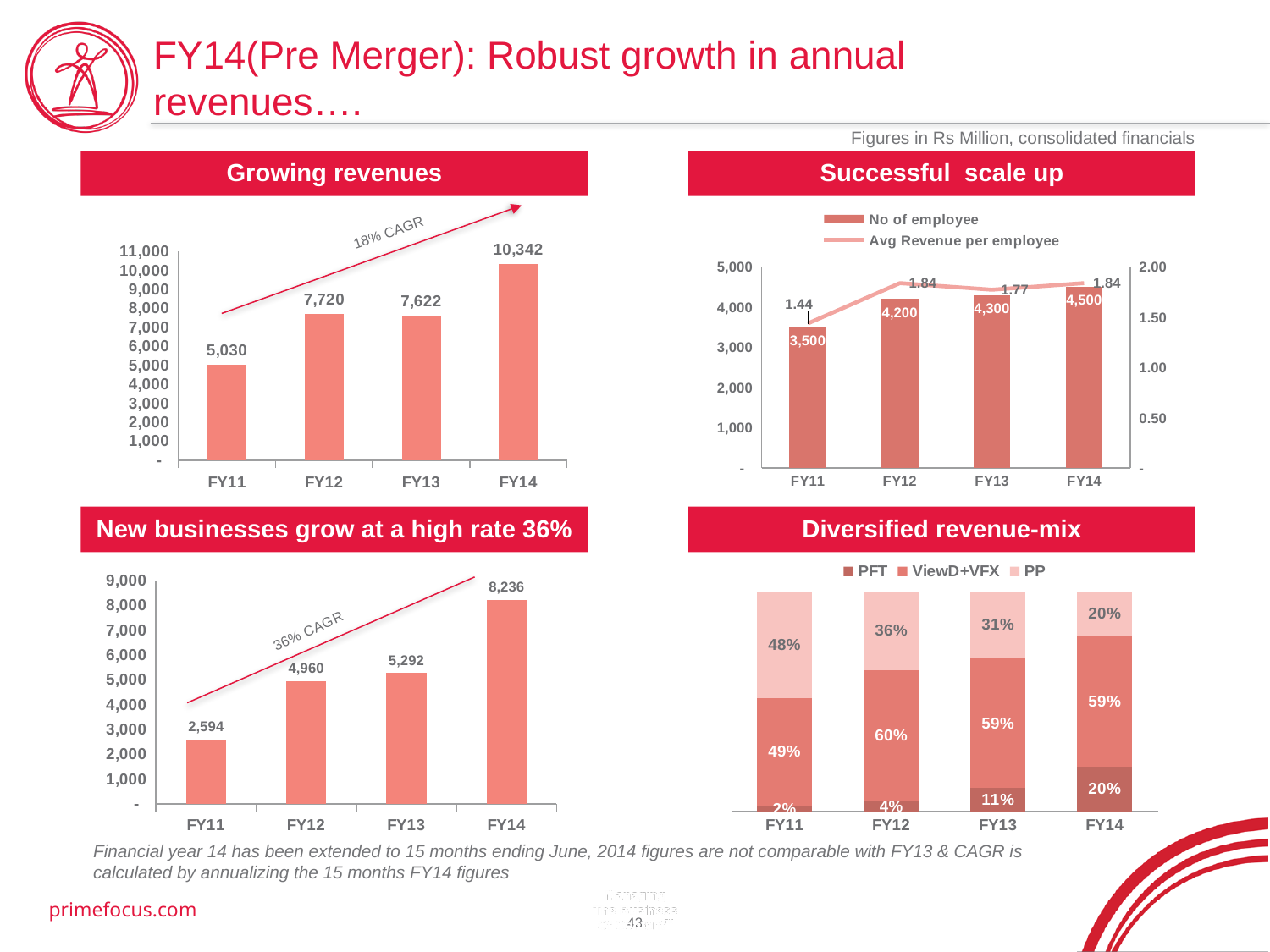
In the 'Diversified revenue-mix' chart, what is the PFT share in FY14? 20% In the 'Successful scale up' chart, how many series does the legend list? 2 In the 'Diversified revenue-mix' chart, what is the PP share in FY11? 48% In the 'New businesses grow at a high rate 36%' chart, do the values generally rise or fall from FY11 to FY14? rise In the 'Growing revenues' chart, which year has the lowest value? FY11 In the 'Growing revenues' chart, what is the difference between the FY14 and FY11 values? 5,312 In the 'Successful scale up' chart, what is the number of employees in FY13? 4,300 In the 'Growing revenues' chart, which is larger, the FY12 value or the FY13 value? FY12 In the 'Growing revenues' chart, what is the value for FY14? 10,342 In the 'New businesses grow at a high rate 36%' chart, how many years are shown on the x axis? 4 In the 'Successful scale up' chart, what is the average revenue per employee in FY11? 1.44 In the 'New businesses grow at a high rate 36%' chart, what is the value for FY12? 4,960